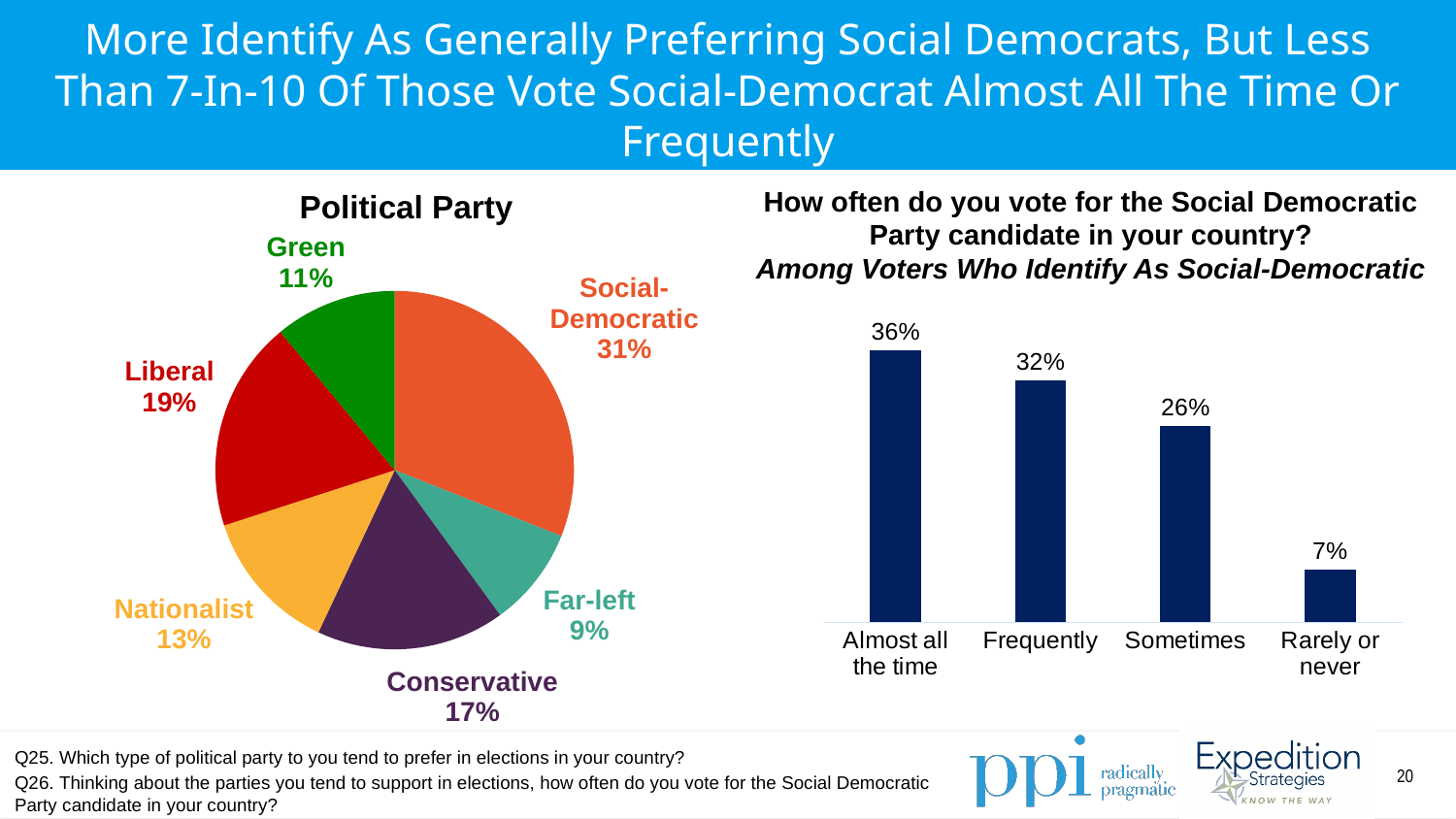
In the 'How often do you vote for the Social Democratic Party candidate' chart, what is the difference between 'Almost all the time' and 'Sometimes'? 10% In the 'Political Party' pie chart, how many parties are shown? 6 In the 'Political Party' pie chart, which party has the largest slice? Social-Democratic In the 'How often do you vote for the Social Democratic Party candidate' chart, which category has the lowest value? Rarely or never In the 'Political Party' pie chart, what share do Social-Democratic voters make up? 31% What type of chart is the chart on the left of the slide? Pie chart In the 'Political Party' pie chart, what is the difference between the Liberal and Nationalist shares? 6% What type of chart is the chart on the right of the slide? Bar chart In the 'Political Party' pie chart, which is larger, the Conservative share or the Green share? Conservative In the 'Political Party' pie chart, which party has the smallest slice? Far-left In the 'How often do you vote for the Social Democratic Party candidate' chart, do the values rise or fall from left to right? Fall In the 'How often do you vote for the Social Democratic Party candidate' chart, what is the value for 'Frequently'? 32%